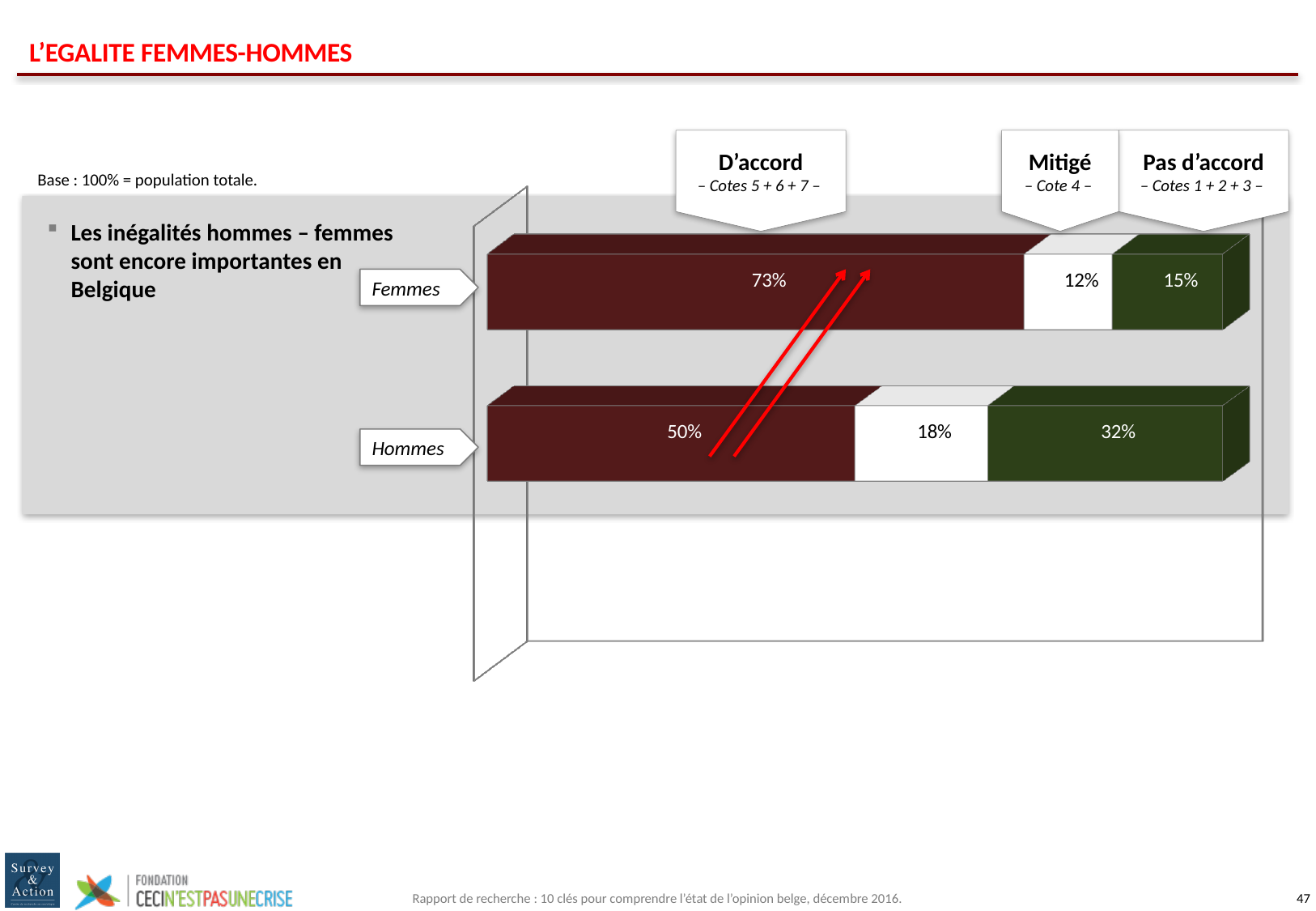
Which group has the higher "D'accord" share, Femmes or Hommes? Femmes What is the difference in percentage points between the "D'accord" values for Femmes and Hommes? 23 What is the difference in percentage points between the "Pas d'accord" values for Hommes and Femmes? 17 What kind of chart is shown on the slide? Stacked bar chart How many groups (bars) are shown in the chart? 2 What is the "Mitigé" value for Femmes? 12% What is the "Mitigé" value for Hommes? 18% Which group has the higher "Pas d'accord" share, Femmes or Hommes? Hommes Which response category is shown in dark green? Pas d'accord What percentage of Femmes are "D'accord"? 73% What percentage of Hommes are "Pas d'accord"? 32% How many response categories does each bar break down into? 3